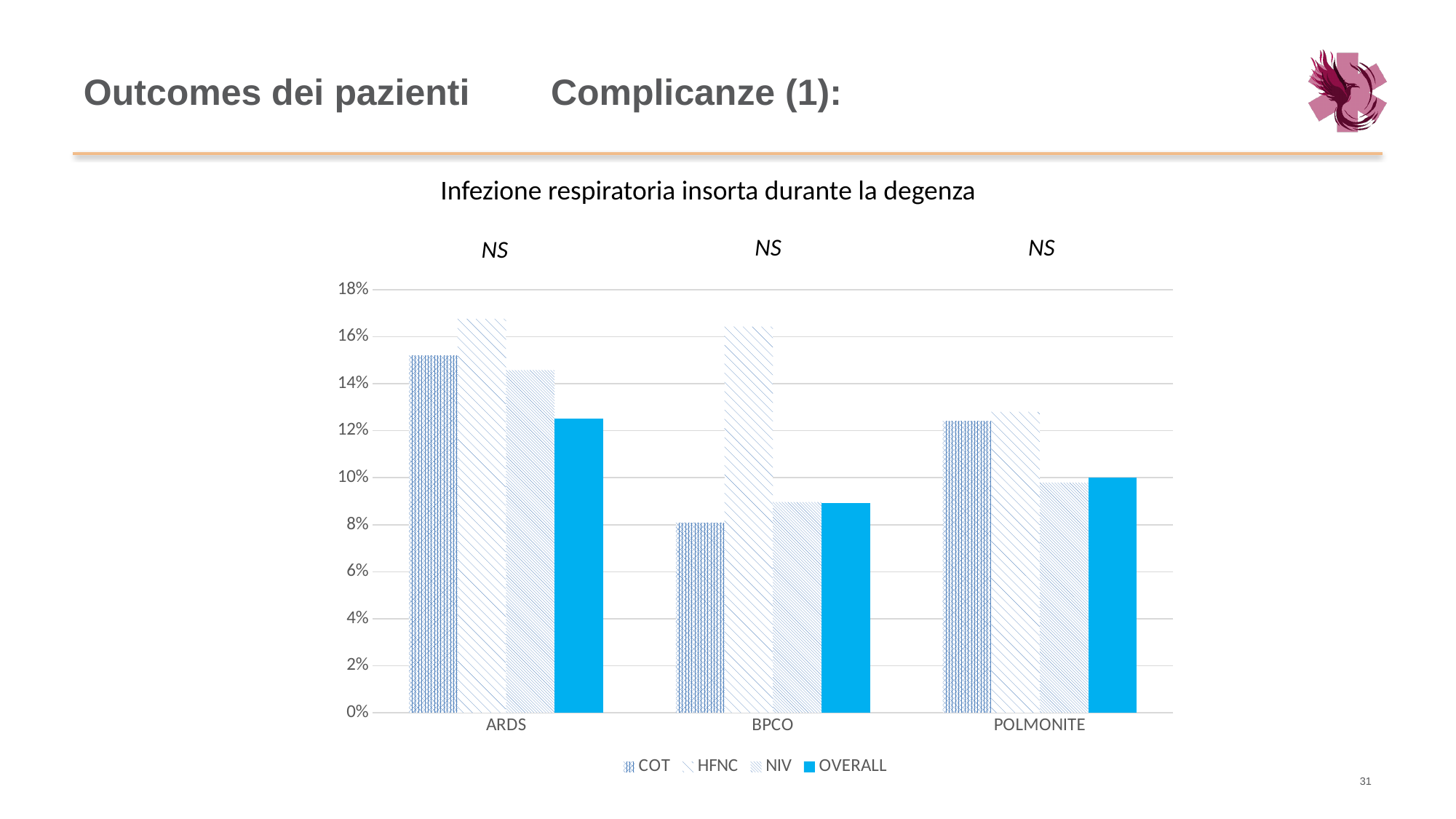
Which series has the highest value for BPCO? HFNC Which series are listed in the chart legend? COT, HFNC, NIV, OVERALL What is the title of the chart? Infezione respiratoria insorta durante la degenza Is the COT value for BPCO greater or less than 10%? less How many categories are shown on the x axis of the chart? 3 Is the HFNC value for ARDS greater or less than 16%? greater Is the COT value larger for ARDS or for BPCO? ARDS How many series does the chart legend list? 4 Is the HFNC value for BPCO greater or less than 14%? greater What kind of chart is shown on the slide? bar chart Which series has the lowest value for ARDS? OVERALL